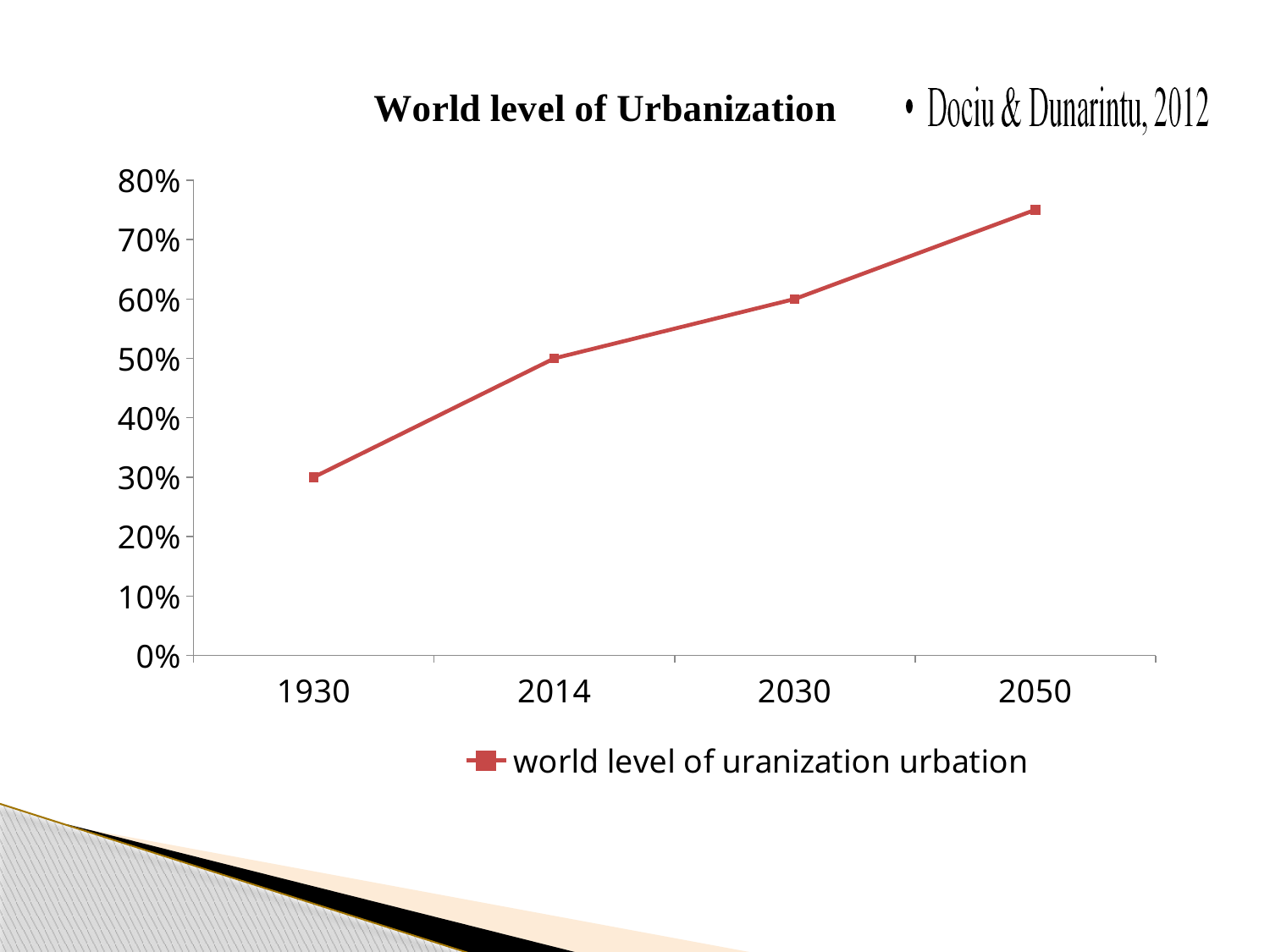
Which is larger, the value for 2030 or the value for 2014? 2030 How many years are plotted on the x axis? 4 Which year has the highest world level of urbanization? 2050 What is the world level of urbanization for 1930? 30% Do the values rise or fall from 1930 to 2050? rise Is the value for 1930 greater or less than 40%? less What is the world level of urbanization for 2014? 50% What kind of chart is shown on the slide? line chart What is the difference between the values for 2014 and 1930? 20% Which year has the lowest world level of urbanization? 1930 Is the value for 2050 greater or less than 70%? greater What is the world level of urbanization for 2030? 60%